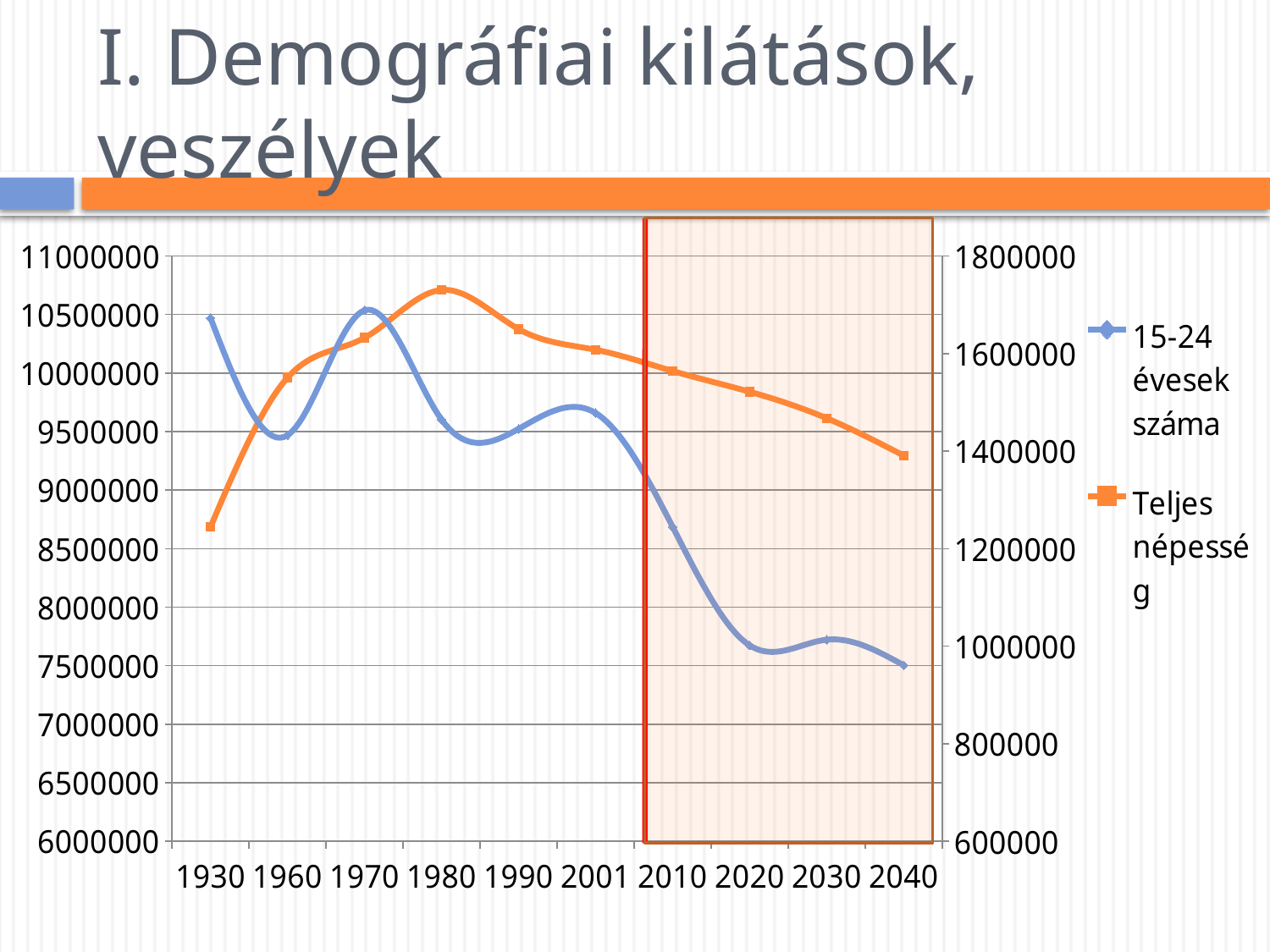
In which year does the Teljes népesség series have its lowest value? 1930 Reading the left axis, is the value for Teljes népesség in 1930 greater or less than 9000000? less Which series is drawn in orange with square markers? Teljes népesség What kind of chart is shown on the slide? line chart Which is larger for Teljes népesség: the value in 1930 or the value in 2040? 2040 Which series is drawn in blue with diamond markers? 15-24 évesek száma In which year does the Teljes népesség series reach its highest value? 1980 Does the 15-24 évesek száma series rise or fall from 2010 to 2040? fall How many series does the legend list? 2 Reading the left axis, is the value for Teljes népesség in 1980 greater or less than 10500000? greater How many years are marked on the x axis? 10 Reading the right axis, is the value for 15-24 évesek száma in 2040 greater or less than 1000000? less